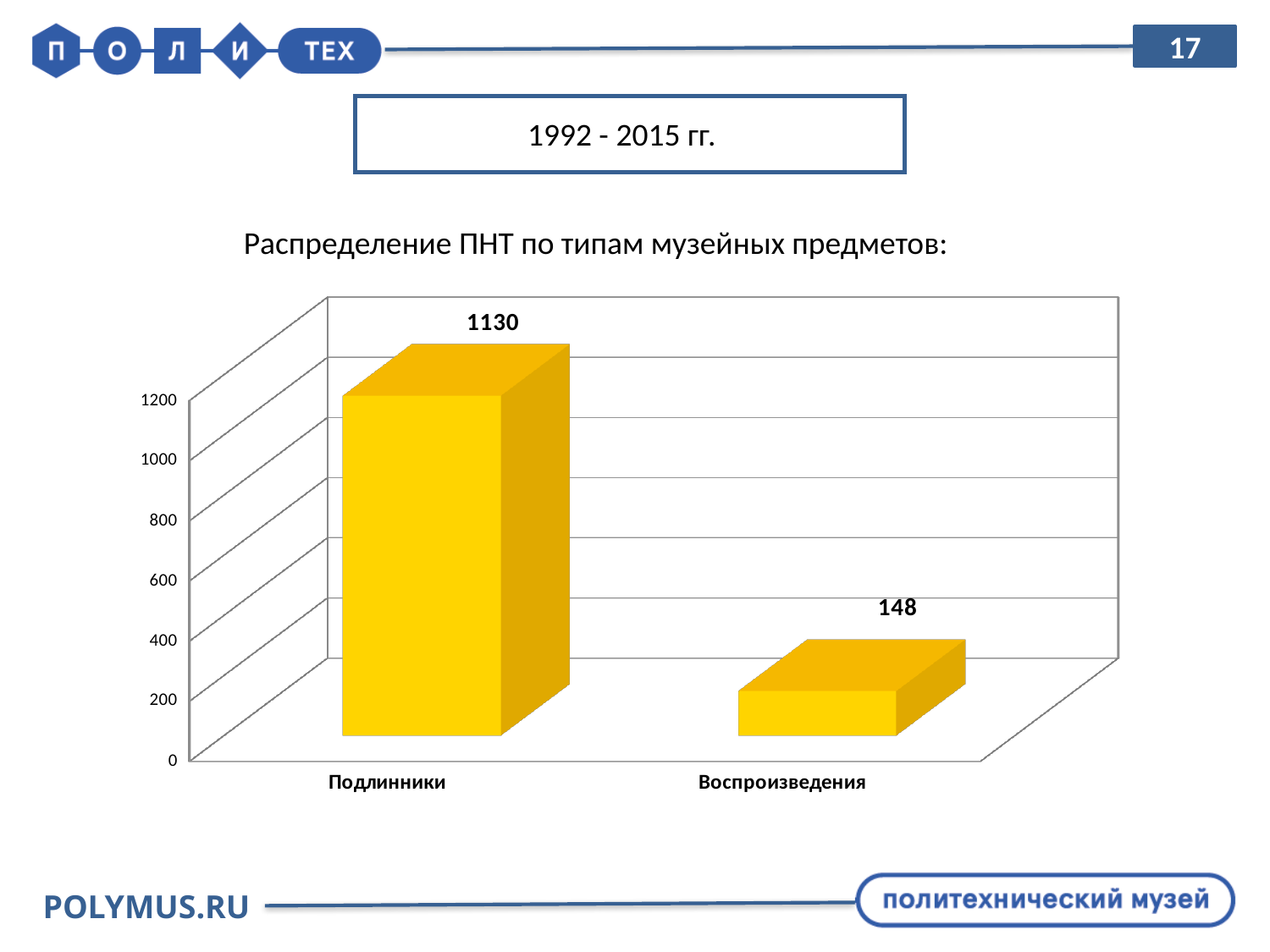
How many categories are shown on the chart? 2 What is the difference between the values for Подлинники and Воспроизведения? 982 What kind of chart is shown on the slide? bar chart Is the value for Подлинники greater or less than 1000? greater Which is larger, the value for Подлинники or the value for Воспроизведения? Подлинники Is the value for Воспроизведения greater or less than 200? less Which category has the lowest value? Воспроизведения What is the value for Подлинники? 1130 What is the total of the two values shown on the chart? 1278 Which category has the highest value? Подлинники What period is indicated in the box above the chart? 1992 - 2015 гг. What is the value for Воспроизведения? 148